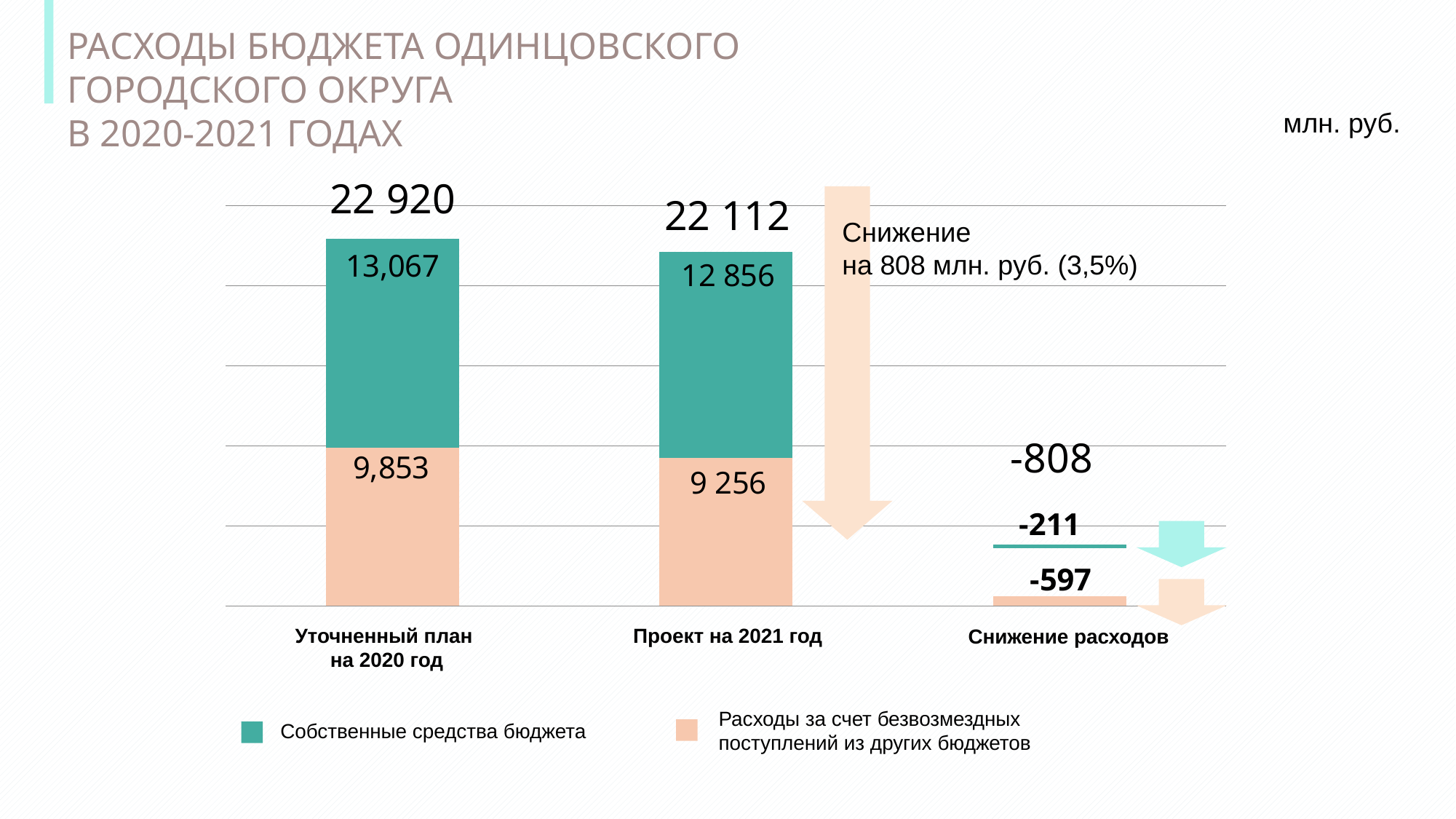
What is the total of the stacked bar for "Уточненный план на 2020 год"? 22 920 What is the total of the stacked bar for "Проект на 2021 год"? 22 112 Which is larger: "Собственные средства бюджета" for "Уточненный план на 2020 год" or for "Проект на 2021 год"? Уточненный план на 2020 год What kind of chart is shown on the slide? bar chart What is the value of "Расходы за счет безвозмездных поступлений из других бюджетов" for "Проект на 2021 год"? 9 256 What is the value of "Собственные средства бюджета" for "Проект на 2021 год"? 12 856 What is the value of "Расходы за счет безвозмездных поступлений из других бюджетов" for "Уточненный план на 2020 год"? 9,853 How many series does the legend list? 2 What is the value of "Расходы за счет безвозмездных поступлений из других бюджетов" for "Снижение расходов"? -597 What is the value of "Собственные средства бюджета" for "Уточненный план на 2020 год"? 13,067 What unit is stated for the values on the chart? млн. руб. What is the value of "Собственные средства бюджета" for "Снижение расходов"? -211